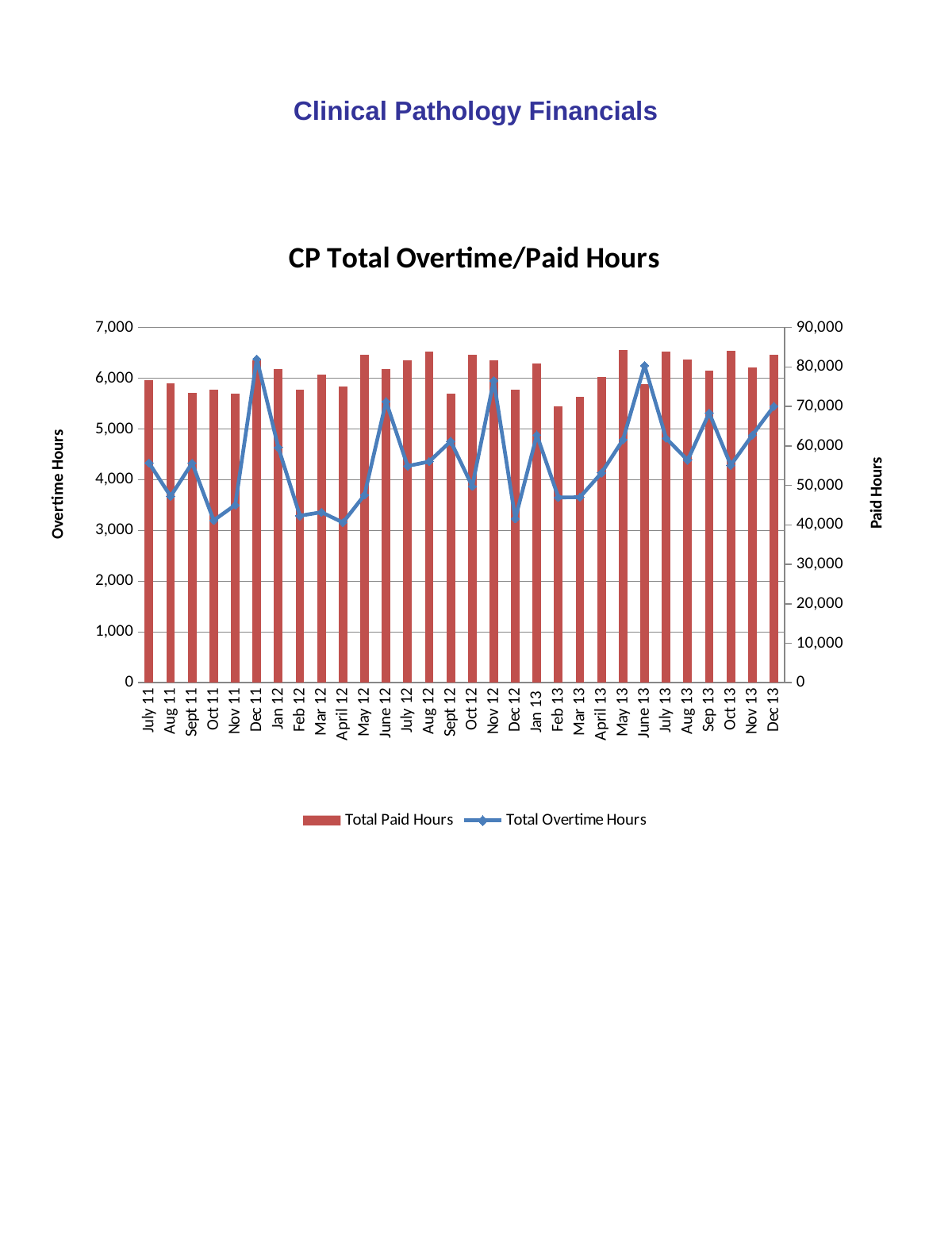
How many series does the legend list? 2 What is the title of the chart? CP Total Overtime/Paid Hours What kind of chart is this? Combination bar and line chart How many months are shown on the x axis? 30 Is the Total Paid Hours value for Feb 13 greater or less than 80,000? less Which month has the larger Total Overtime Hours value, Dec 11 or Feb 12? Dec 11 Which series is drawn as a line with markers? Total Overtime Hours In which month does the Total Overtime Hours line reach its highest point? Dec 11 Which month has the lowest Total Paid Hours bar? Feb 13 Is the Total Overtime Hours value for Dec 11 greater or less than 6,000? greater Is the Total Overtime Hours value for Feb 12 greater or less than 4,000? less Which month has the larger Total Paid Hours value, Feb 13 or May 13? May 13